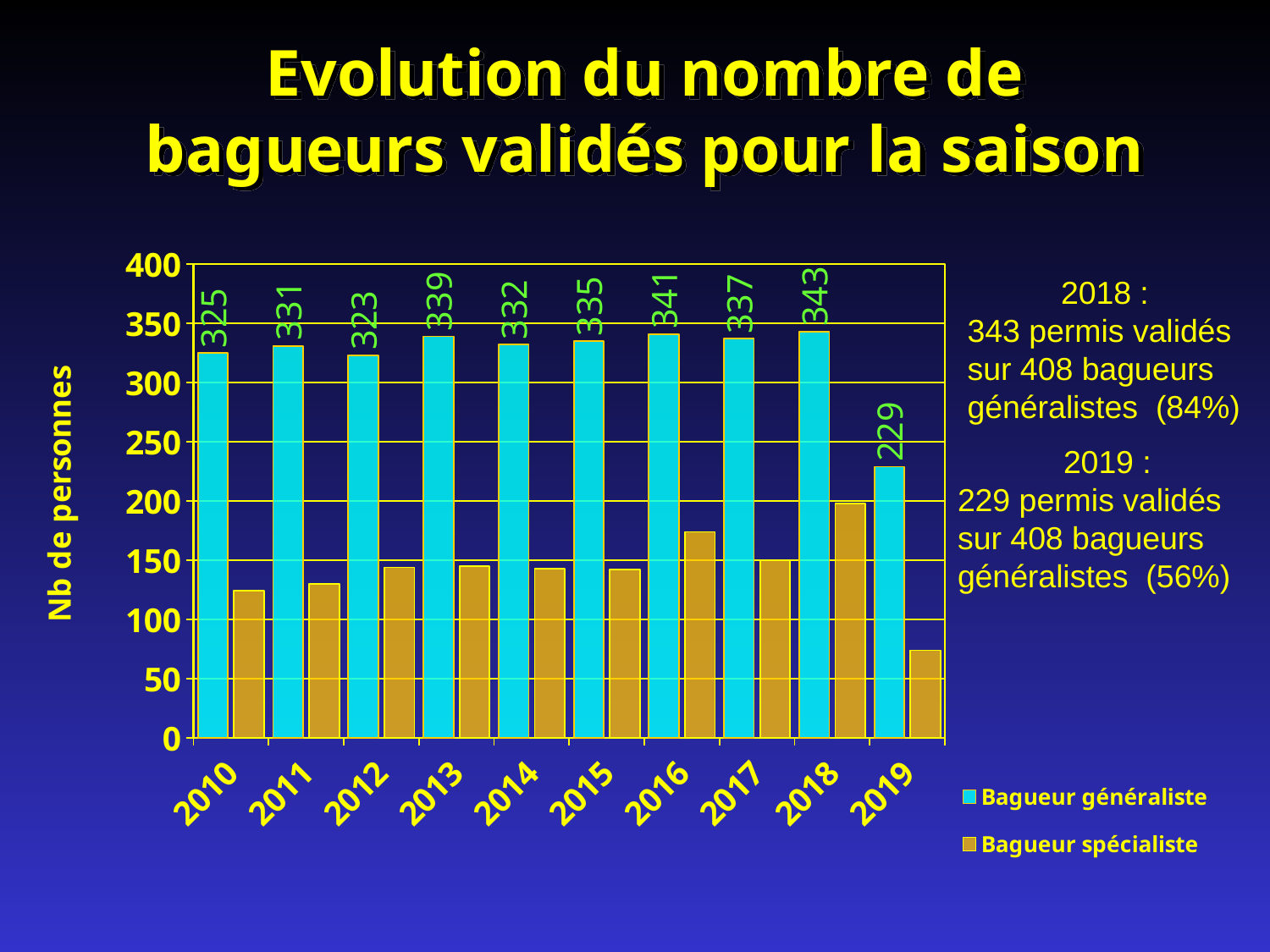
What is the value for Bagueur généraliste in 2019? 229 How many years are shown on the x axis? 10 Which year has the lowest value for Bagueur généraliste? 2019 What is the difference between the Bagueur généraliste values for 2018 and 2019? 114 Is the value for Bagueur spécialiste in 2019 greater or less than 100? less Which is larger, the Bagueur généraliste value for 2013 or for 2014? 2013 Which year has the highest value for Bagueur généraliste? 2018 How many series does the legend list? 2 What is the value for Bagueur généraliste in 2018? 343 Is the value for Bagueur spécialiste in 2018 greater or less than 150? greater What is the value for Bagueur généraliste in 2012? 323 What kind of chart is shown on the slide? bar chart